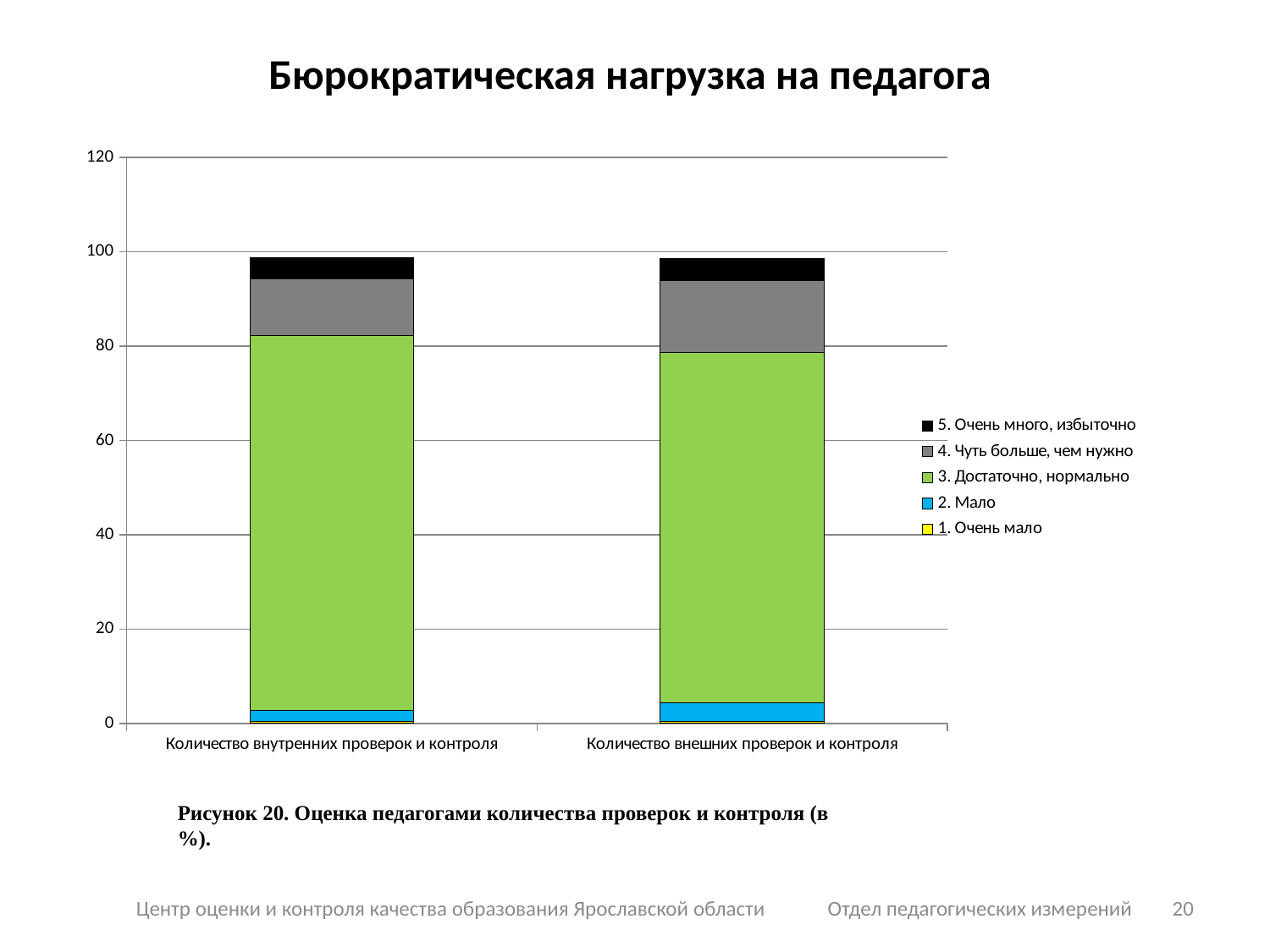
Is the total height of the stacked bar for "Количество внешних проверок и контроля" greater or less than 120? less What is the title of the slide containing the chart? Бюрократическая нагрузка на педагога Is the top of the "3. Достаточно, нормально" segment for "Количество внешних проверок и контроля" greater or less than 80? less Is the total height of the stacked bar for "Количество внутренних проверок и контроля" greater or less than 80? greater What kind of chart is shown on the slide? stacked bar chart Which category has the larger "4. Чуть больше, чем нужно" segment: "Количество внутренних проверок и контроля" or "Количество внешних проверок и контроля"? Количество внешних проверок и контроля Which category has the larger "3. Достаточно, нормально" segment: "Количество внутренних проверок и контроля" or "Количество внешних проверок и контроля"? Количество внутренних проверок и контроля How many categories are shown on the x axis of the chart? 2 Which legend entry is shown in green? 3. Достаточно, нормально How many series does the chart's legend list? 5 Which series forms the largest segment in both stacked bars? 3. Достаточно, нормально